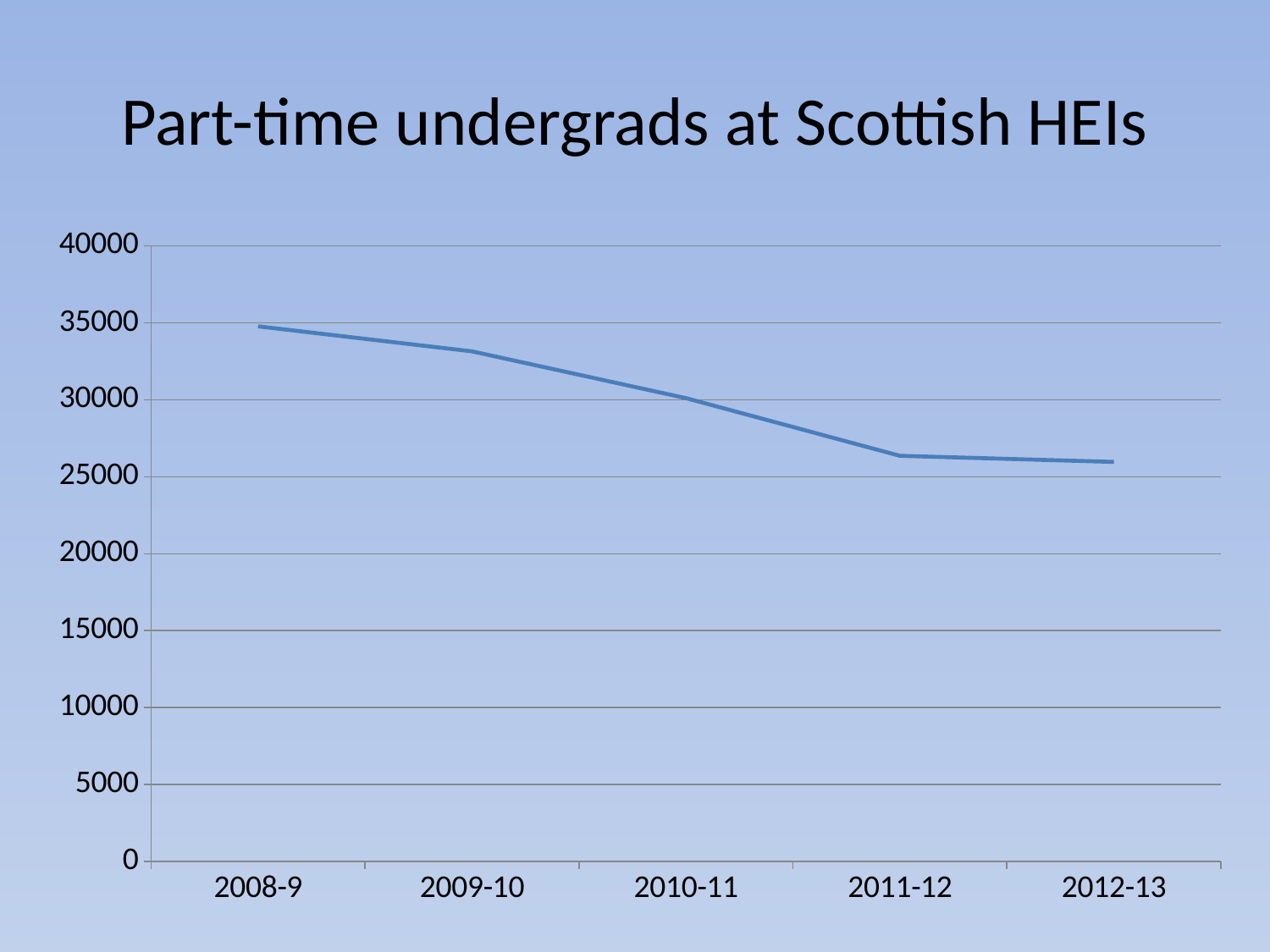
Which is larger, the value for 2008-9 or the value for 2011-12? 2008-9 What is the title of the chart? Part-time undergrads at Scottish HEIs Which academic year has the highest value? 2008-9 Which is larger, the value for 2009-10 or the value for 2012-13? 2009-10 Is the value for 2009-10 greater or less than 35000? less Do the values rise or fall from 2008-9 to 2012-13? fall How many academic years are plotted on the x axis? 5 Is the value for 2012-13 greater or less than 25000? greater What is the highest value shown on the y axis? 40000 Is the value for 2008-9 greater or less than 30000? greater What kind of chart is shown on the slide? line chart